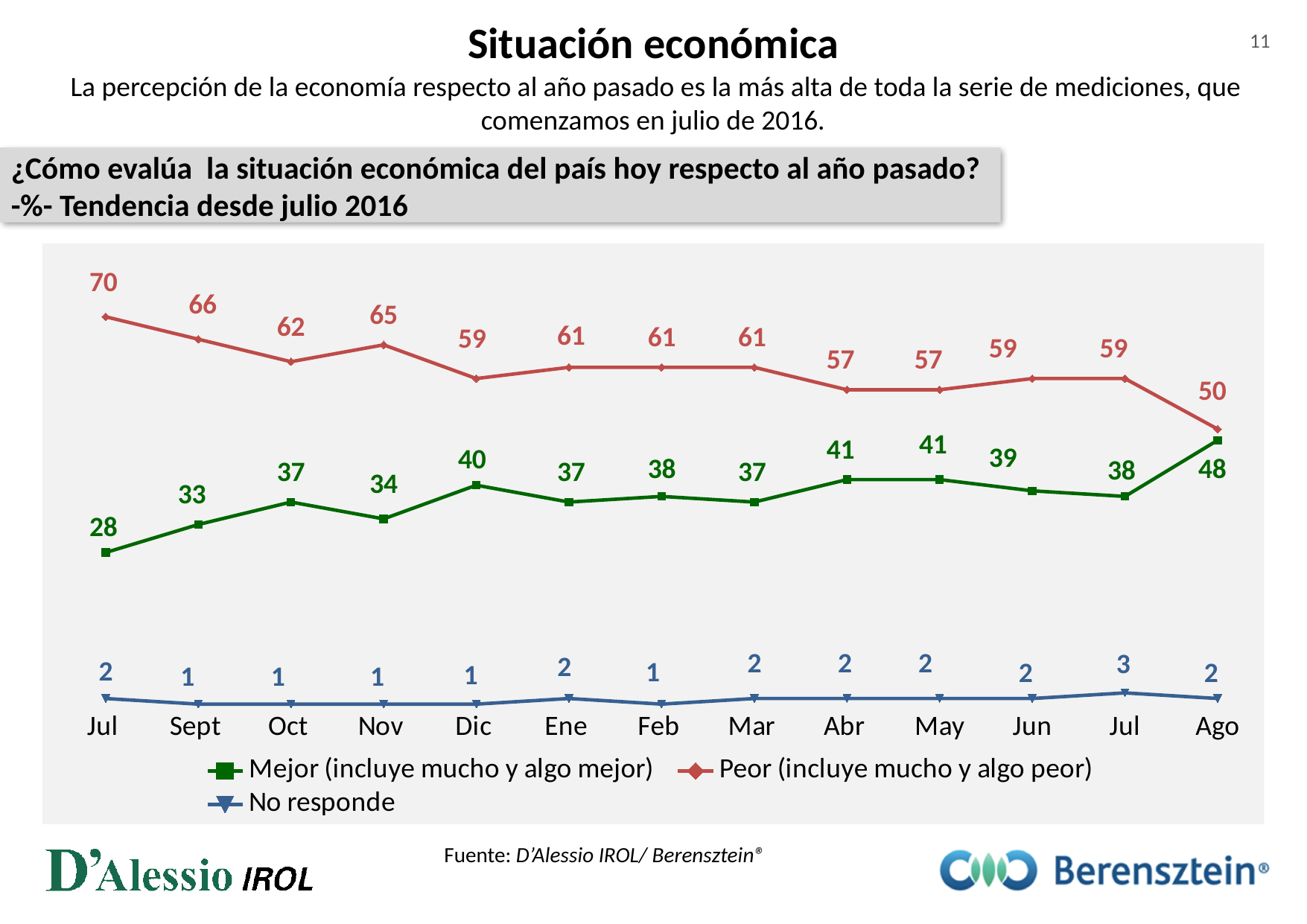
In which month does the 'Peor (incluye mucho y algo peor)' series reach its lowest value? Ago What is the difference between the 'Peor' and 'Mejor' values in Ago? 2 What is the value of the 'Mejor (incluye mucho y algo mejor)' series in Ago? 48 How many series does the legend list? 3 What is the value of the 'No responde' series in the second Jul? 3 What kind of chart is shown on the slide? Line chart What is the difference between the 'Peor' value in the first Jul and the 'Peor' value in Ago? 20 How many months (data points) are plotted along the x axis? 13 What is the value of the 'Peor (incluye mucho y algo peor)' series in Jul (the first point)? 70 Which is larger in Dic: the 'Mejor' value or the 'Peor' value? Peor Does the 'Peor (incluye mucho y algo peor)' series generally rise or fall from the first Jul to Ago? Fall In which month does the 'Mejor (incluye mucho y algo mejor)' series reach its highest value? Ago